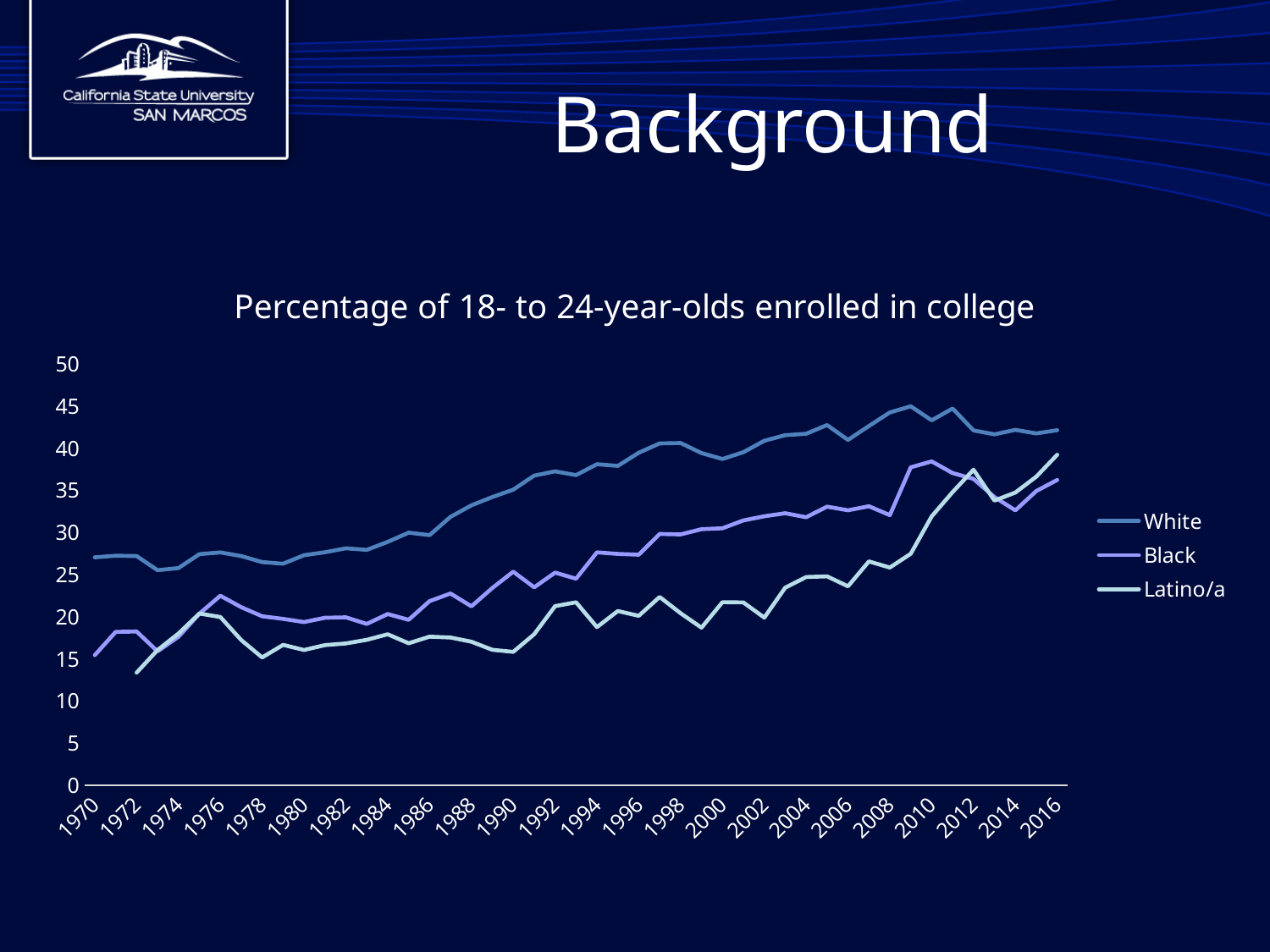
What kind of chart is shown on the slide? line chart Is the value for Latino/a in 2016 greater or less than 35? greater Is the value for White in 2010 greater or less than 40? greater Which series is plotted highest across the whole period? White In 2000, which is larger, the value for White or the value for Black? White Which series has the lowest value in 1972? Latino/a Does the White series generally rise or fall from 1970 to 2016? rise Is the value for Black in 1970 greater or less than 20? less How many series does the legend list? 3 What is the title of the chart? Percentage of 18- to 24-year-olds enrolled in college